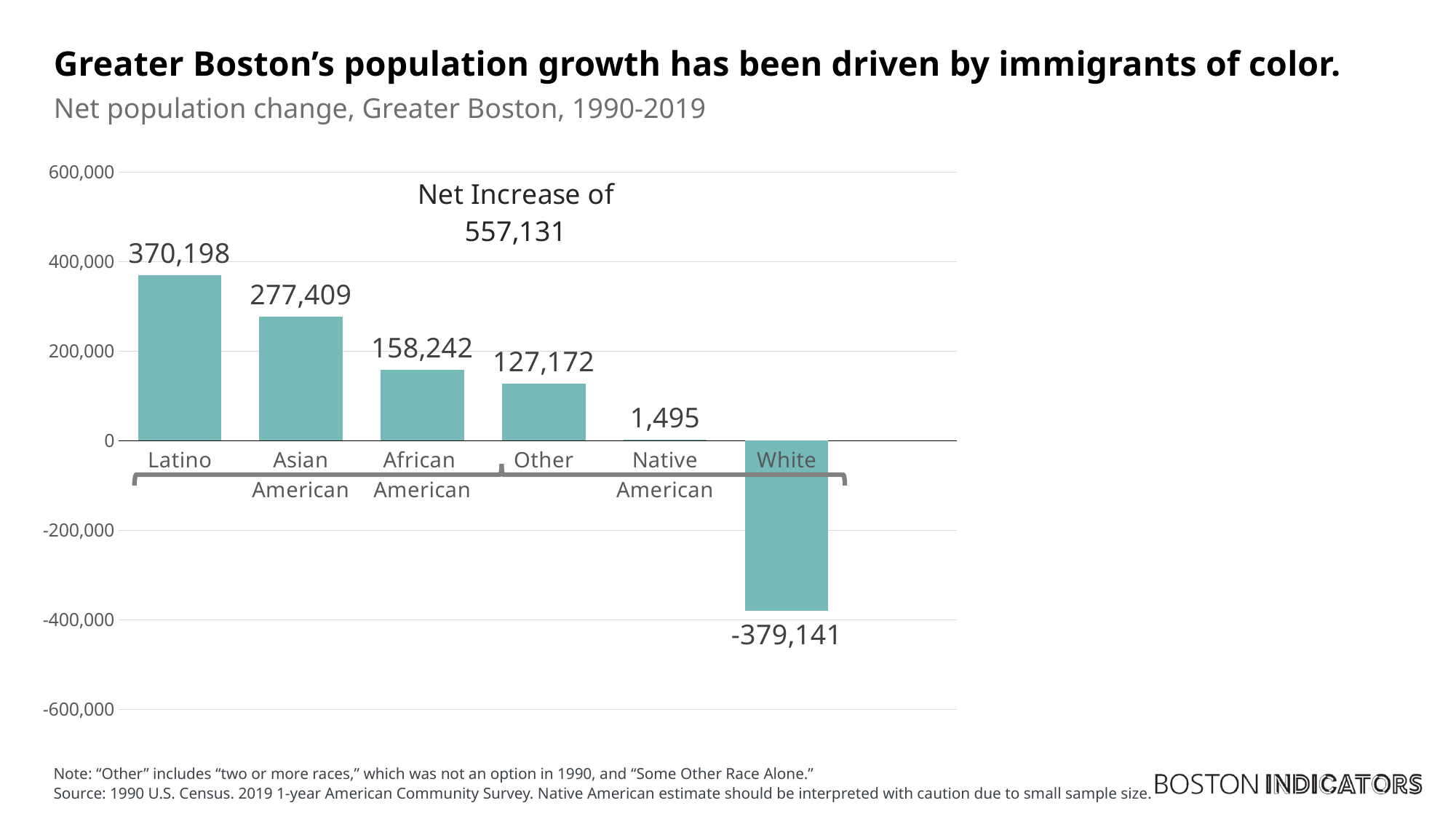
What is the difference between the net population change for Latino and Asian American residents? 92,789 How many categories are shown on the chart? 6 What net increase is annotated on the chart? 557,131 Is the value for Other greater or less than 200,000? less What is the net population change for Latino residents? 370,198 Which is larger, the net population change for African American or Other residents? African American Which category has the lowest net population change? White What kind of chart is shown on the slide? Bar chart Which category has the highest net population change? Latino What is the net population change for Native American residents? 1,495 What is the net population change for White residents? -379,141 What is the net population change for Asian American residents? 277,409